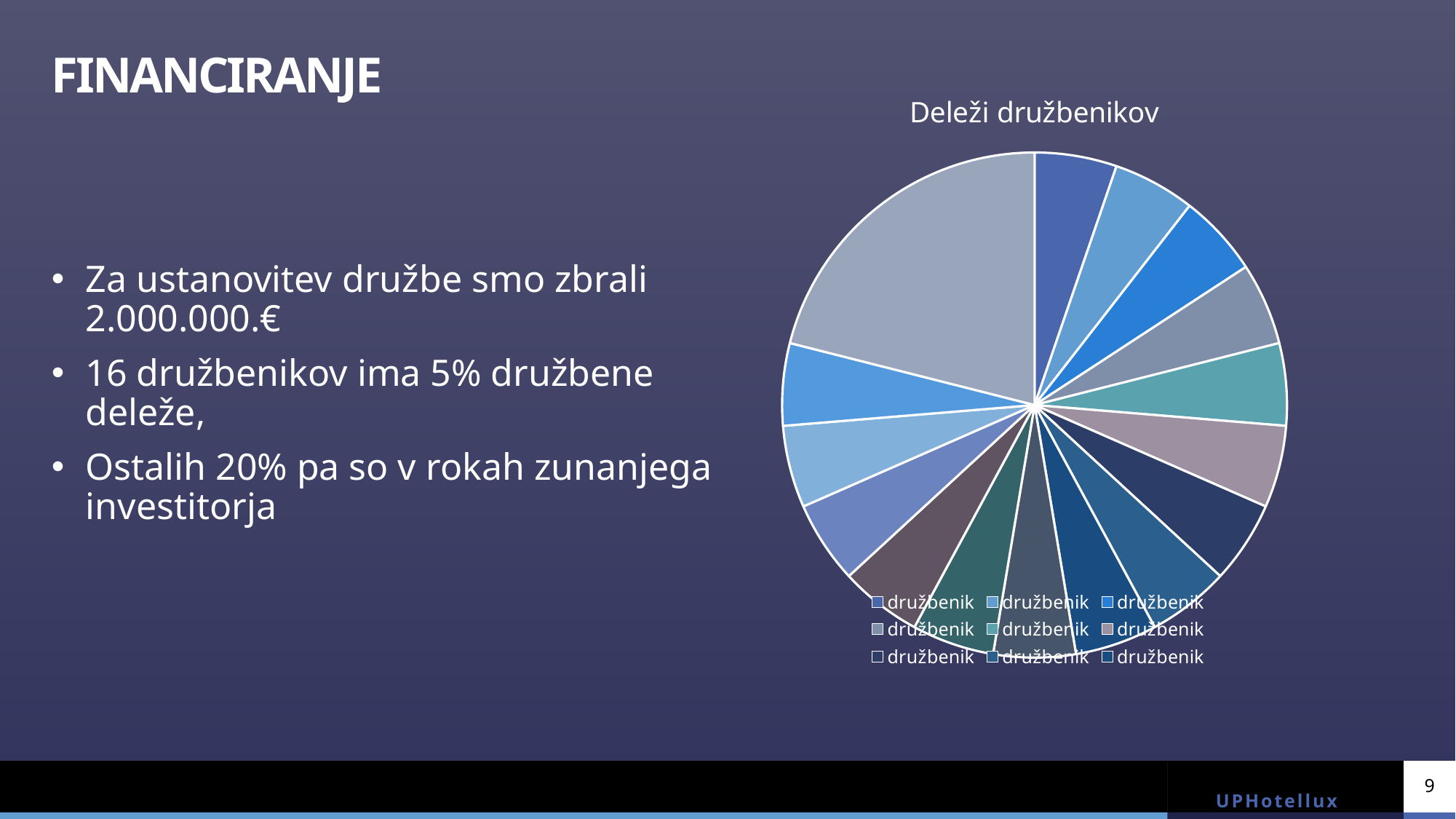
What kind of chart is shown on the slide? pie chart Are all the slices of the pie chart the same size? no What label is repeated for the entries in the pie chart's legend? družbenik What is the title of the pie chart? Deleži družbenikov